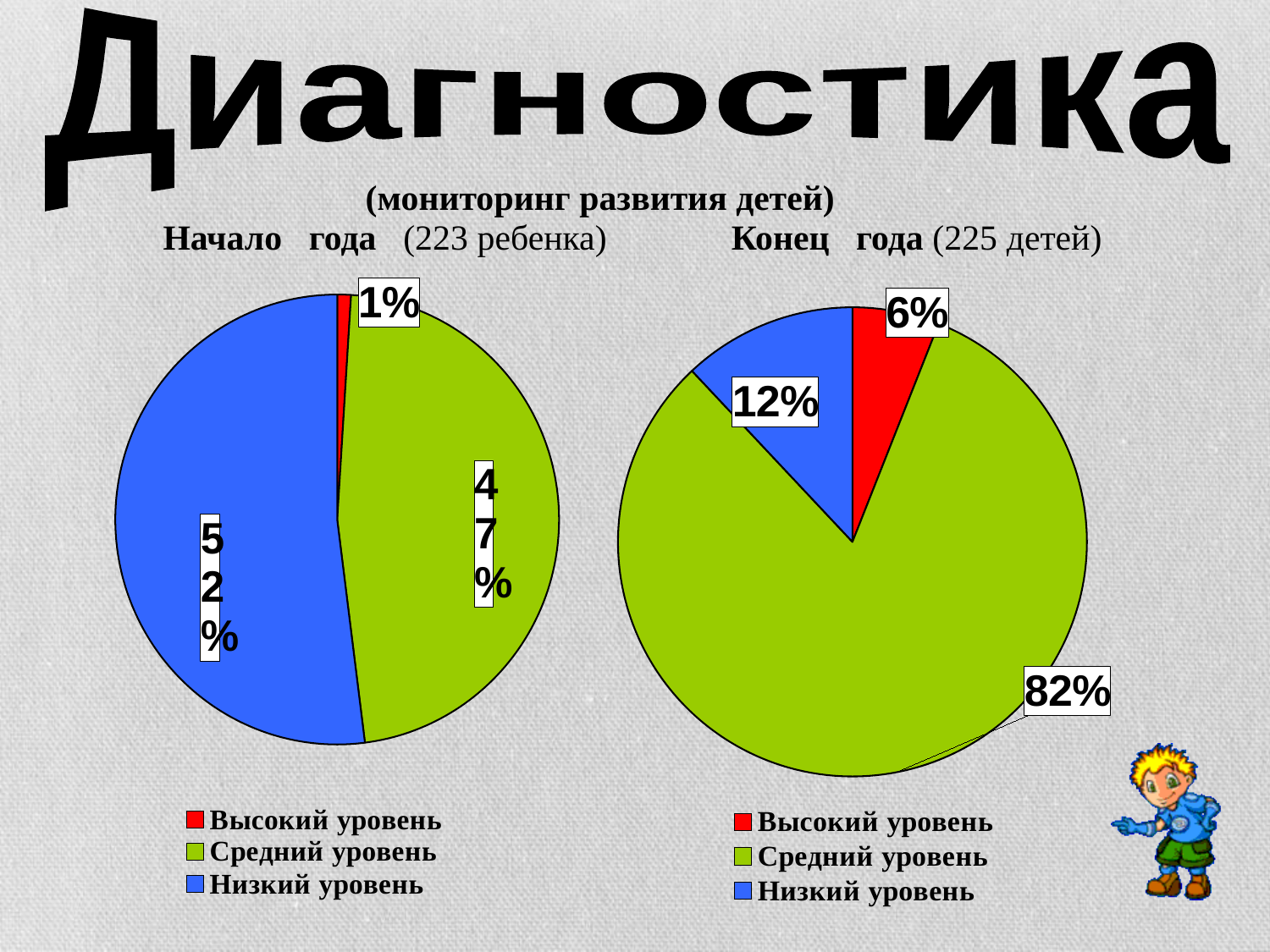
In the 'Конец года' pie chart, what is the difference between the shares of Средний уровень and Низкий уровень? 70% How many categories does the legend of the 'Конец года' pie chart list? 3 In the 'Начало года' pie chart, what percentage is shown for Средний уровень? 47% What type of chart is used for 'Начало года'? Pie chart In the 'Начало года' pie chart, what percentage is shown for Высокий уровень? 1% In the 'Конец года' pie chart, which category has the smallest share? Высокий уровень In the 'Конец года' pie chart, what percentage is shown for Низкий уровень? 12% In the 'Начало года' pie chart, what percentage is shown for Низкий уровень? 52% In the 'Начало года' pie chart, which category has the largest share? Низкий уровень Which is larger: Высокий уровень in the 'Начало года' chart or Высокий уровень in the 'Конец года' chart? Конец года In the 'Конец года' pie chart, what percentage is shown for Высокий уровень? 6% In the 'Конец года' pie chart, what percentage is shown for Средний уровень? 82%